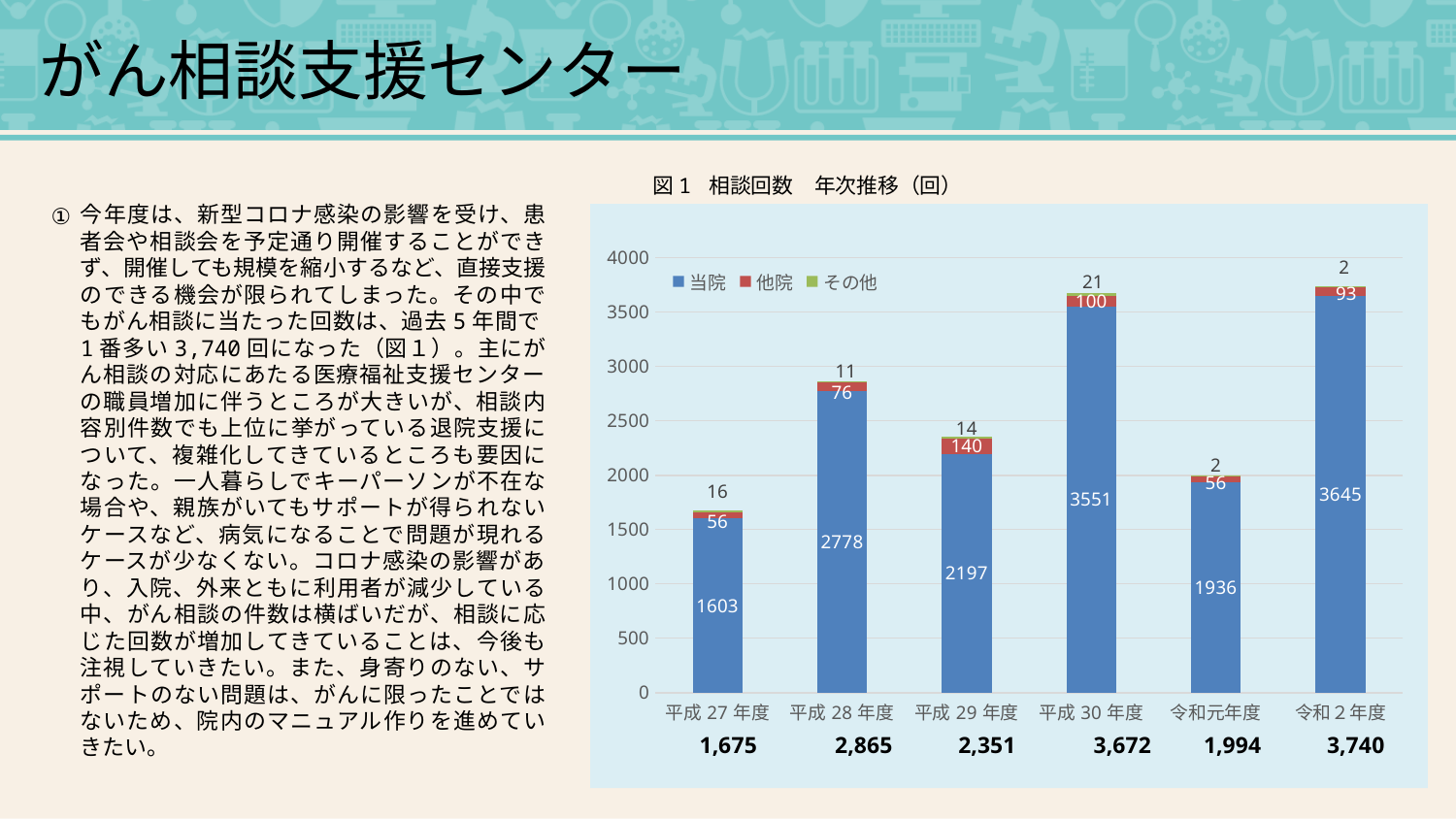
What type of chart is shown on the slide? stacked bar chart Is the total for 令和元年度 greater or less than 2000? less Which fiscal year has the lowest total number of consultations? 平成27年度 How many series does the legend list in the chart 図1 相談回数 年次推移（回）? 3 How many fiscal-year categories are shown on the x axis of the chart? 6 What is the value for その他 in 令和元年度? 2 Which fiscal year has the highest value for 当院? 令和2年度 Which is larger, the 他院 value for 平成30年度 or for 令和2年度? 平成30年度 What is the value for 他院 in 平成29年度? 140 What is the total of the stacked bar for 令和2年度? 3,740 What is the difference between the 当院 values for 平成28年度 and 平成27年度? 1175 What is the value for 当院 in 平成30年度? 3551